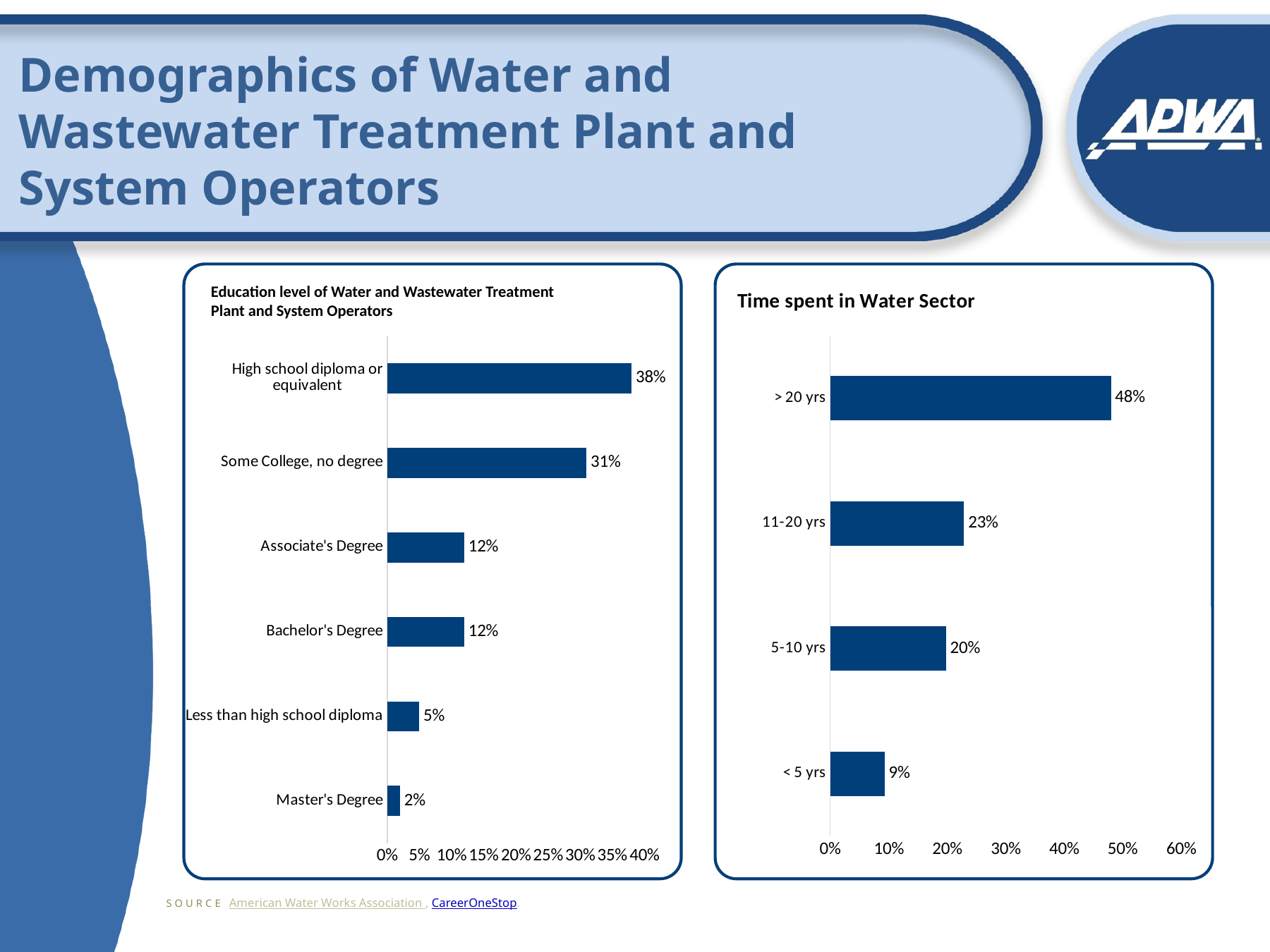
In the 'Time spent in Water Sector' chart, which is larger: the value for 11-20 yrs or the value for < 5 yrs? 11-20 yrs In the 'Education level of Water and Wastewater Treatment Plant and System Operators' chart, what percentage of operators have a high school diploma or equivalent? 38% In the 'Education level' chart on the left, what is the value for Some College, no degree? 31% In the 'Education level' chart on the left, how many education categories are shown? 6 In the 'Time spent in Water Sector' chart, what is the difference between the > 20 yrs value and the 11-20 yrs value? 25% In the 'Education level' chart on the left, which education level has the lowest percentage? Master's Degree In the 'Education level' chart on the left, what is the difference between the High school diploma or equivalent value and the Some College, no degree value? 7% In the 'Time spent in Water Sector' chart, which category has the highest value? > 20 yrs What type of chart is the 'Time spent in Water Sector' chart? Bar chart In the 'Education level' chart on the left, is the value for Less than high school diploma greater or less than 10%? less In the 'Time spent in Water Sector' chart, what percentage of operators have spent more than 20 years in the sector? 48% In the 'Time spent in Water Sector' chart, what is the value for 5-10 yrs? 20%